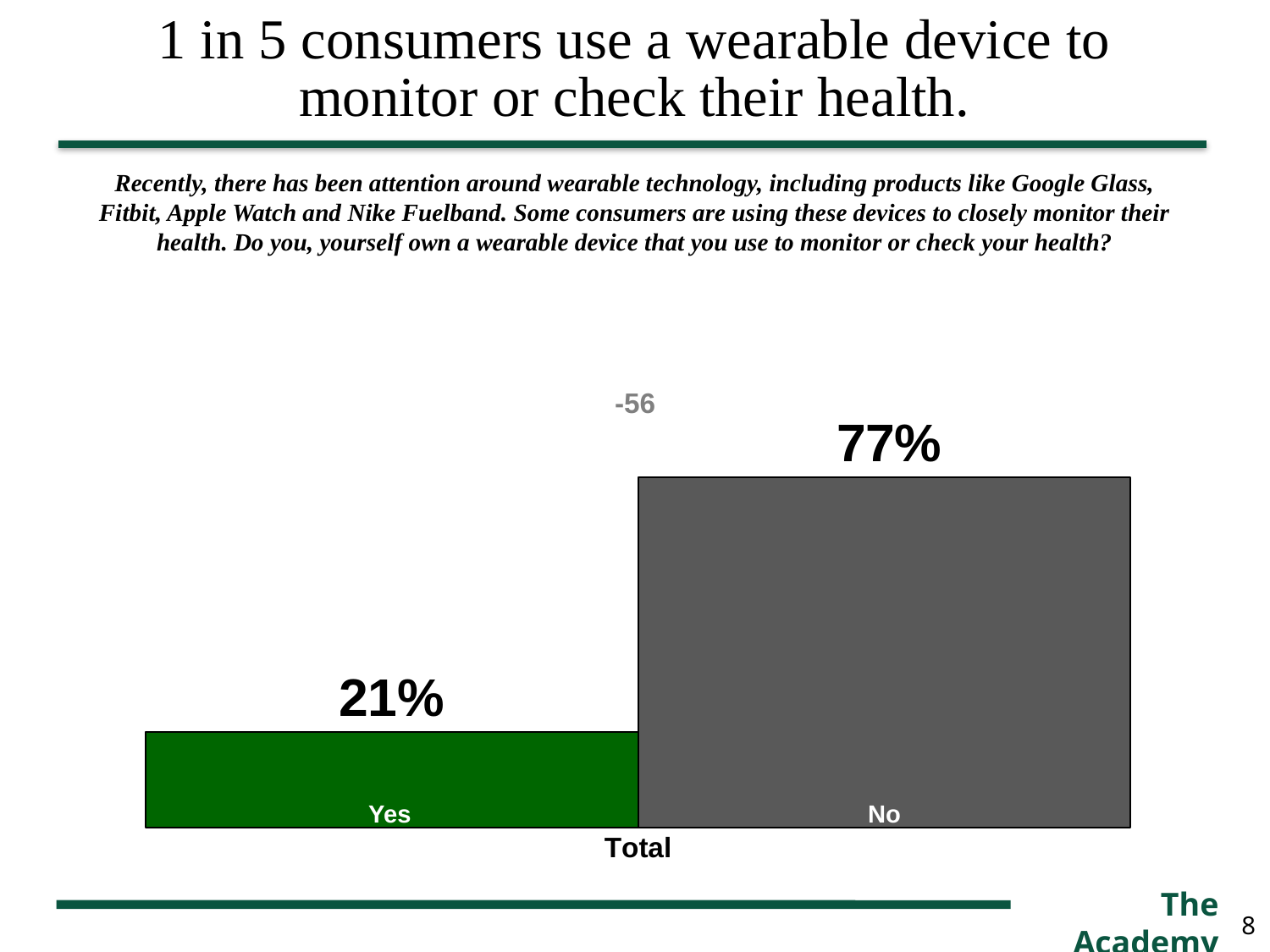
How many response categories are plotted in the chart? 2 Is the value for Yes larger or smaller than the value for No? Smaller What percentage of consumers answered "No" in the chart? 77% What is the label on the category axis beneath the bars? Total What percentage of consumers answered "Yes" to owning a wearable device they use to monitor or check their health? 21% What type of chart is shown on the slide? Bar chart Which response has the lowest percentage in the chart? Yes Which response, Yes or No, has the higher percentage in the chart? No What is the difference in percentage points between the No and Yes responses? 56 percentage points What number is printed in grey above the bars in the chart? -56 What colour is the bar representing the Yes response? Green